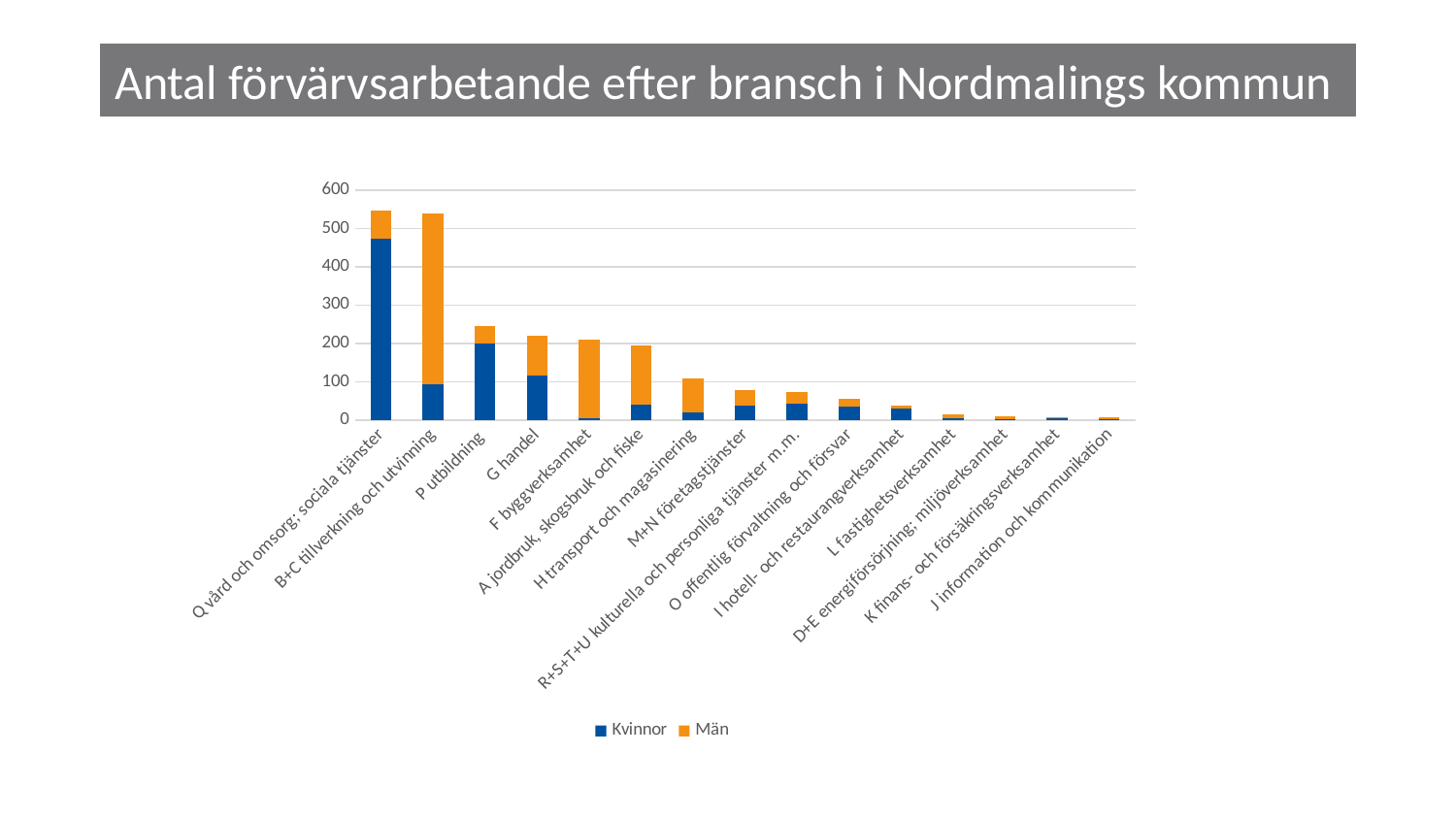
Which category has the highest value for Kvinnor? Q vård och omsorg; sociala tjänster What kind of chart is shown on the slide? Stacked bar chart Do the total values generally rise or fall moving from left to right along the x axis? fall Is the total value for Q vård och omsorg; sociala tjänster greater or less than 500? greater Is the Kvinnor value for Q vård och omsorg; sociala tjänster greater or less than 400? greater Which category has the highest value for Män? B+C tillverkning och utvinning Which series are listed in the legend? Kvinnor and Män Is the total value for M+N företagstjänster greater or less than 100? less Which has a larger total value, P utbildning or M+N företagstjänster? P utbildning What is the title of the chart? Antal förvärvsarbetande efter bransch i Nordmalings kommun How many series does the legend list? 2 How many industry categories are shown on the x axis? 15